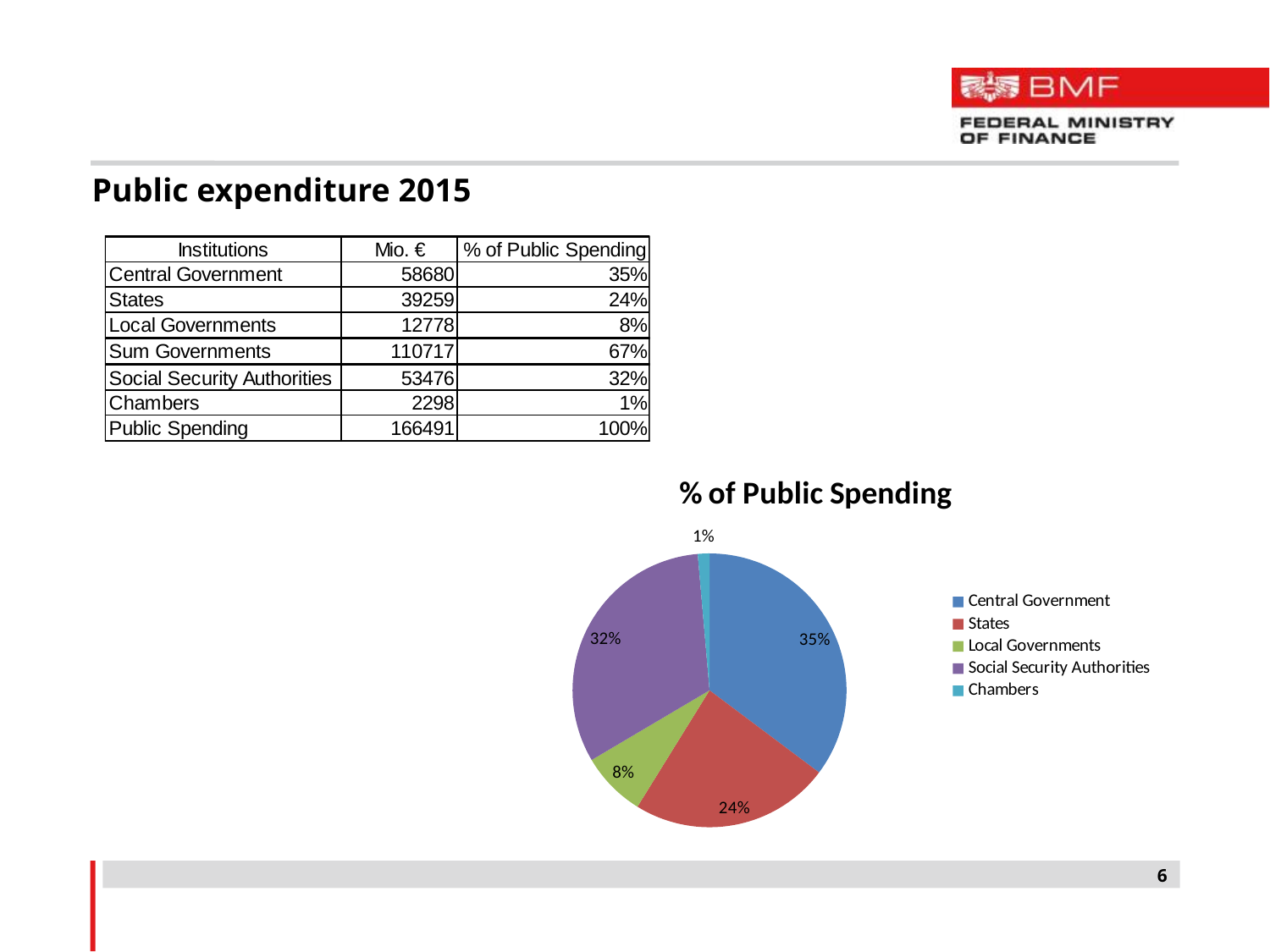
Which category has the smallest slice of the pie? Chambers What share of public spending does the Central Government slice represent? 35% What kind of chart is shown on the slide? pie chart Which category has the largest slice of the pie? Central Government Which slice is larger, Social Security Authorities or States? Social Security Authorities What share of public spending does the Local Governments slice represent? 8% What share of public spending does the Chambers slice represent? 1% What is the difference in percentage points between the Central Government and States slices? 11% How many categories does the legend list? 5 What is the chart's title? % of Public Spending